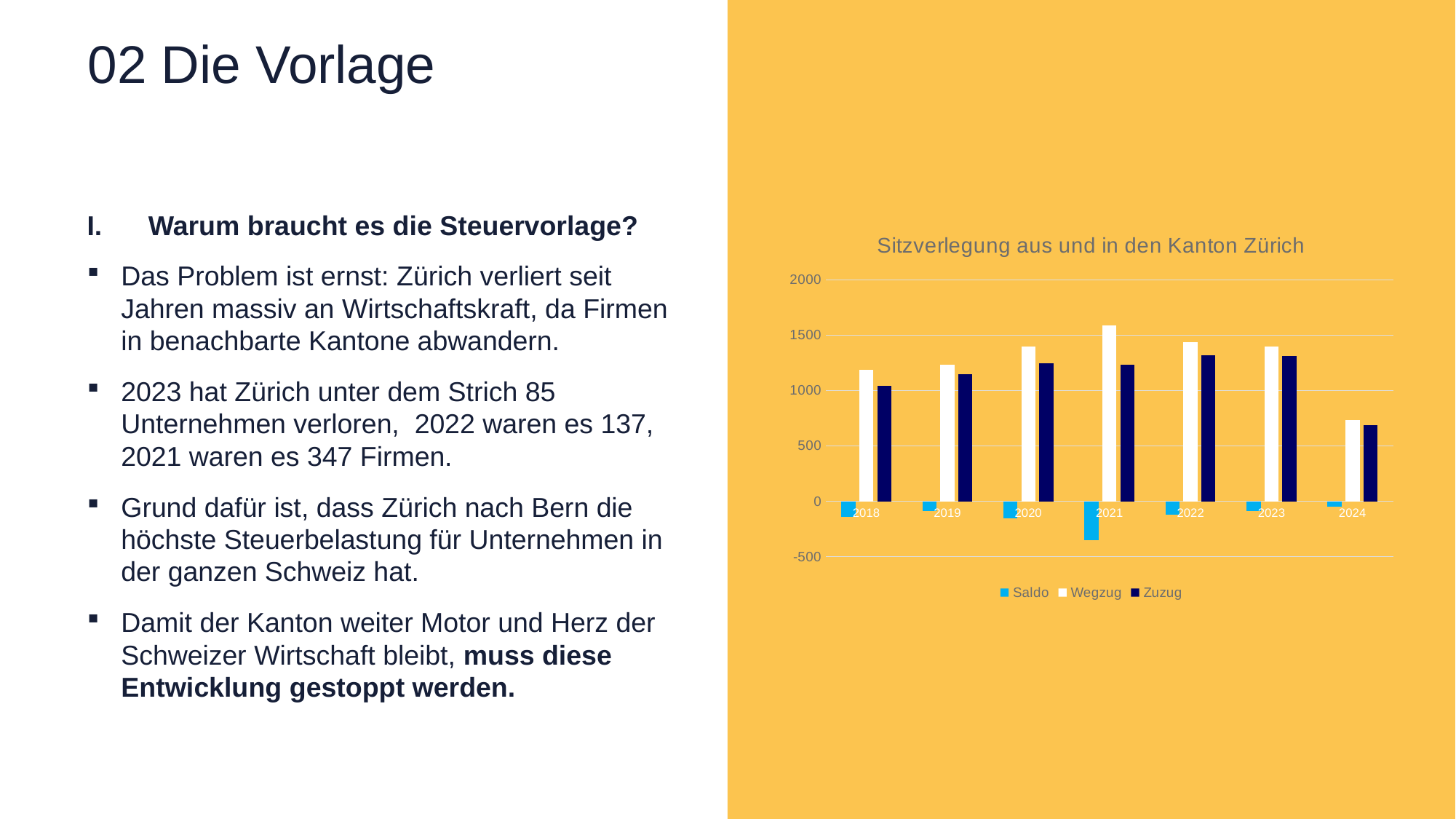
In which year is the Zuzug bar the lowest? 2024 Is the Zuzug value for 2024 greater or less than 1000? less How many years are shown on the x axis of the chart? 7 In which year is the Wegzug bar the lowest? 2024 In 2018, which is larger, Wegzug or Zuzug? Wegzug What kind of chart is shown on the slide? bar chart In which year is the Wegzug bar the highest? 2021 Is the Saldo value for 2021 greater or less than 0? less What is the title of the chart? Sitzverlegung aus und in den Kanton Zürich In which year is the Saldo bar the lowest (most negative)? 2021 Is the Wegzug value for 2021 greater or less than 1500? greater How many series does the chart's legend list? 3